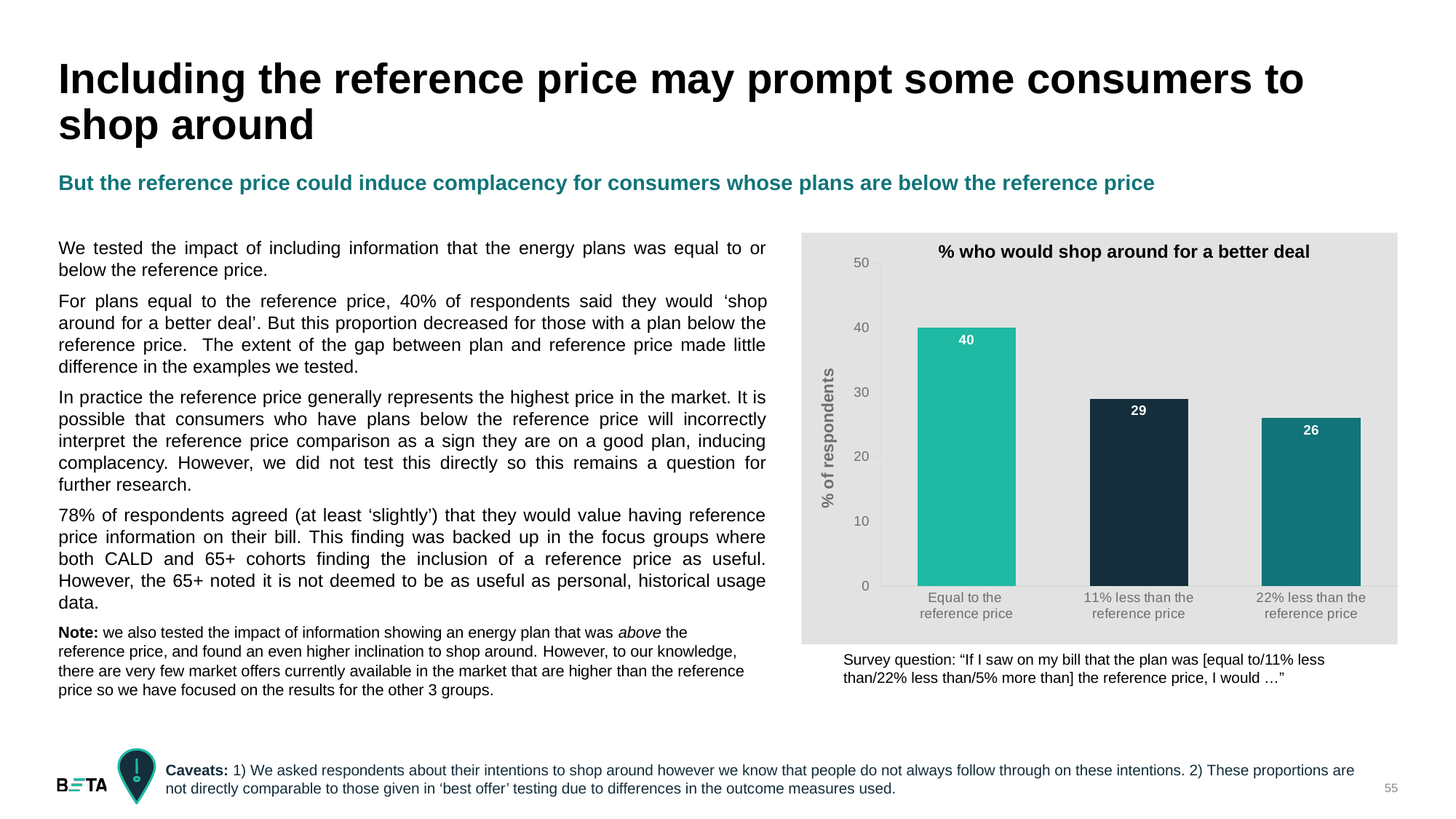
What kind of chart is shown on the slide? Bar chart What is the title of the chart? % who would shop around for a better deal How many categories are shown in the chart? 3 What is the value for '22% less than the reference price'? 26 What is the value for 'Equal to the reference price'? 40 What is the value for '11% less than the reference price'? 29 Is the value for '11% less than the reference price' greater or less than 30? less Which category has the highest value? Equal to the reference price Which category has the lowest value? 22% less than the reference price Which is larger: the value for 'Equal to the reference price' or '11% less than the reference price'? Equal to the reference price What is the difference between the values for '11% less than the reference price' and '22% less than the reference price'? 3 What is the difference between the values for 'Equal to the reference price' and '22% less than the reference price'? 14